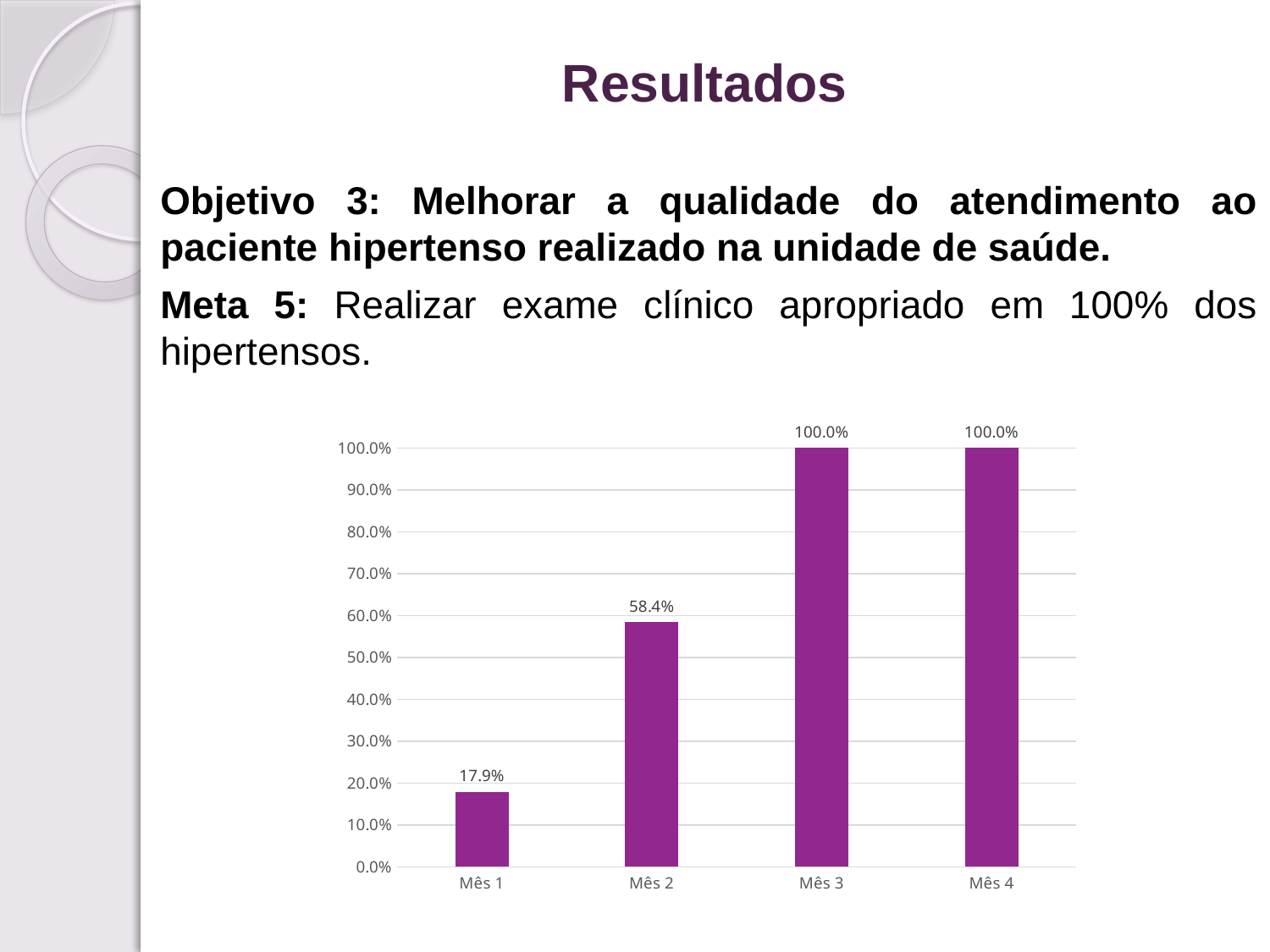
Which month has the lowest value? Mês 1 What is the difference between the values for Mês 2 and Mês 1? 40.5% How many months are shown on the x axis? 4 What colour are the bars in the chart? purple What kind of chart is shown on the slide? bar chart Which is larger, the value for Mês 1 or the value for Mês 2? Mês 2 What is the value for Mês 3? 100.0% Do the values rise or fall from Mês 1 to Mês 3? rise What is the value for Mês 1? 17.9% What is the difference between the values for Mês 3 and Mês 2? 41.6% What is the value for Mês 2? 58.4% Is the value for Mês 2 greater or less than 50.0%? greater